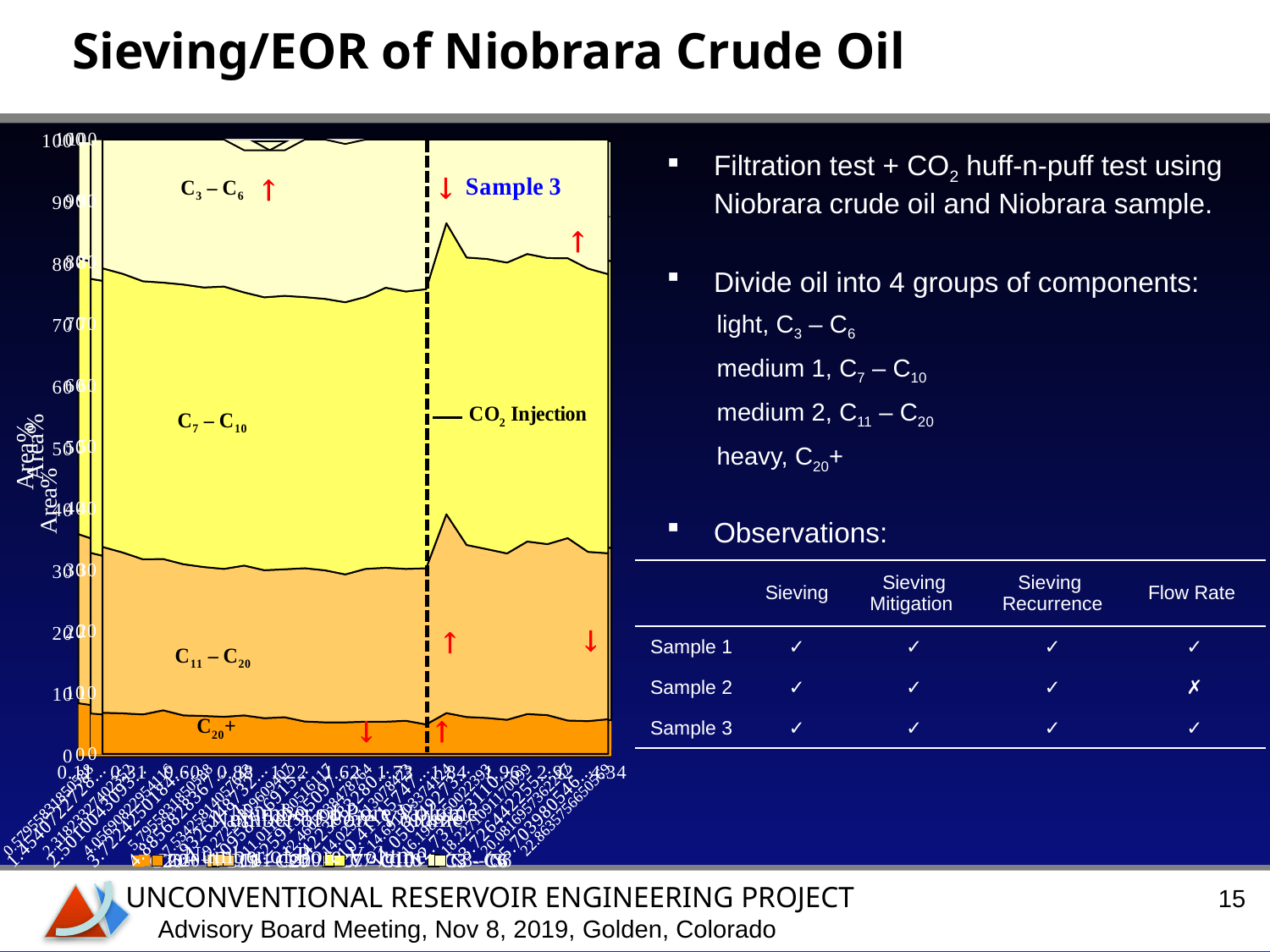
Which component group occupies the topmost region of the chart? C3 – C6 What is the label of the y-axis of the chart? Area% Is the top boundary of the C20+ band greater or less than 10 Area%? less Which component group occupies the largest share of the area in the chart? C7 – C10 Is the top boundary of the C7 – C10 band greater or less than 60 Area%? greater Which of the two groups, C7 – C10 or C20+, occupies a larger share of the chart area? C7 – C10 How many component groups are labeled as regions in the chart? 4 What is the maximum value shown on the y-axis of the chart? 100 What kind of chart is shown on the left of the slide? stacked area chart Which component group occupies the bottom region of the chart? C20+ Which component group occupies the smallest share of the area in the chart? C20+